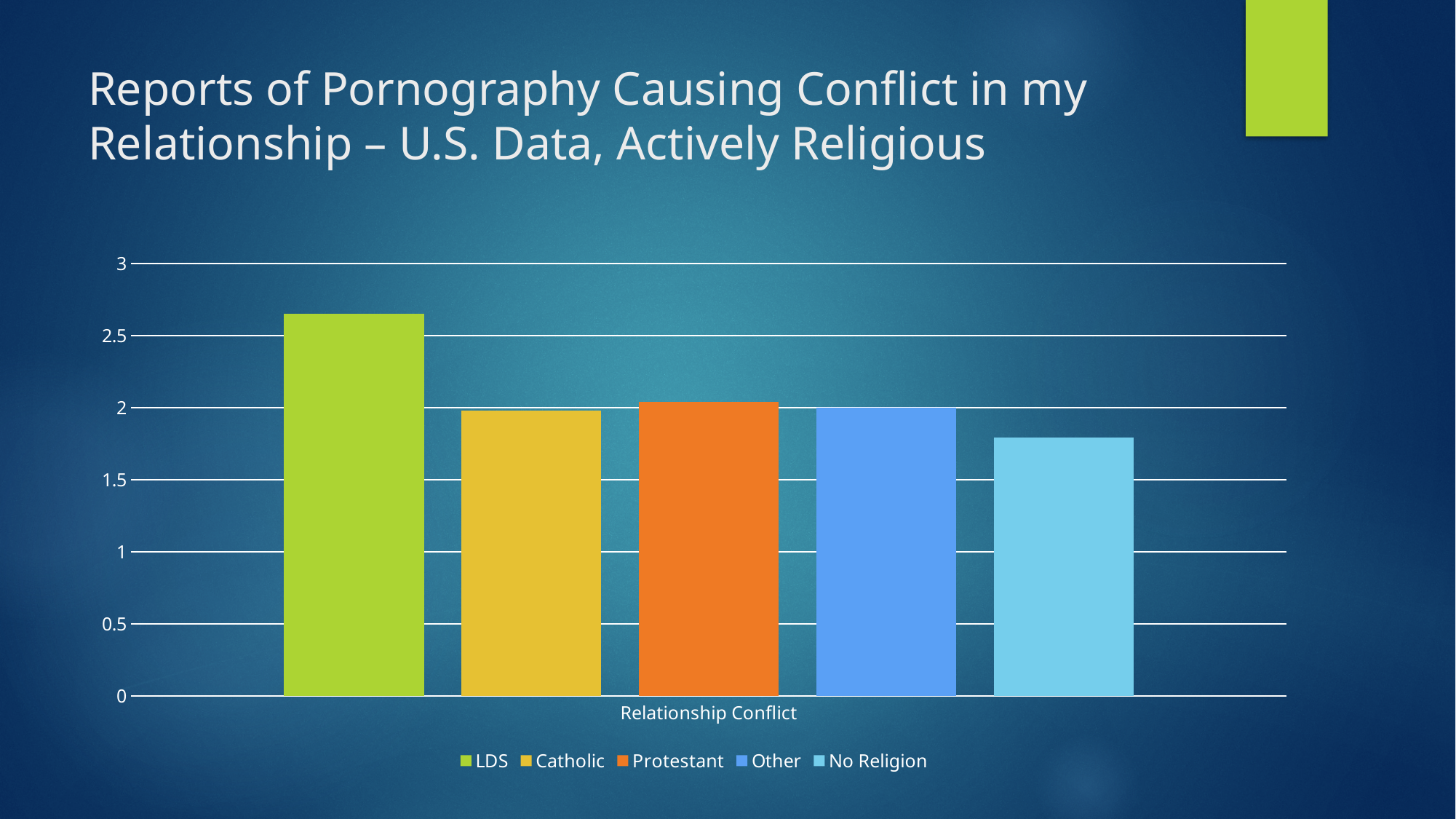
Which is larger, the value for LDS or the value for Catholic? LDS Which group has the highest bar for Relationship Conflict? LDS Which group has the lowest bar for Relationship Conflict? No Religion Which is larger, the value for Protestant or the value for No Religion? Protestant Is the value for No Religion greater or less than 2? less Is the value for LDS greater or less than 2.5? greater What is the category label shown on the x axis of the chart? Relationship Conflict Is the value for Catholic greater or less than 1.5? greater How many bars are plotted in the chart? 5 How many series does the legend list? 5 What kind of chart is shown on the slide? bar chart